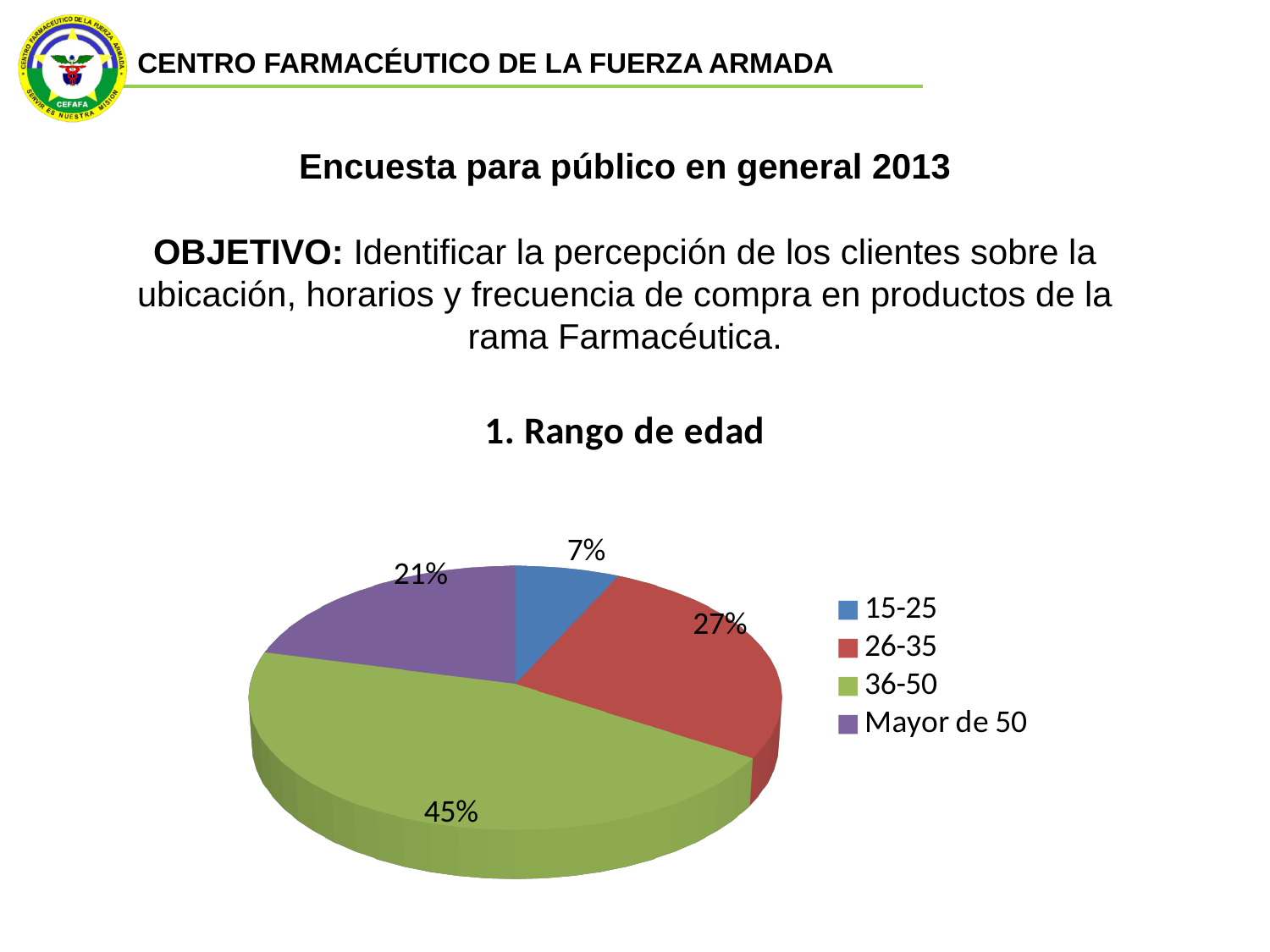
Which age range has the smallest slice of the pie? 15-25 What is the difference between the 36-50 slice and the 26-35 slice? 18% What is the value shown for the 26-35 age range? 27% What kind of chart is shown under "1. Rango de edad"? Pie chart Which is larger, the 26-35 slice or the Mayor de 50 slice? 26-35 What share of the pie does the 36-50 age range have? 45% What colour is the slice for the 36-50 age range? Green What is the difference between the Mayor de 50 slice and the 15-25 slice? 14% What is the value shown for the Mayor de 50 category? 21% How many categories does the pie chart have? 4 Which age range has the largest slice of the pie? 36-50 What is the value shown for the 15-25 age range? 7%